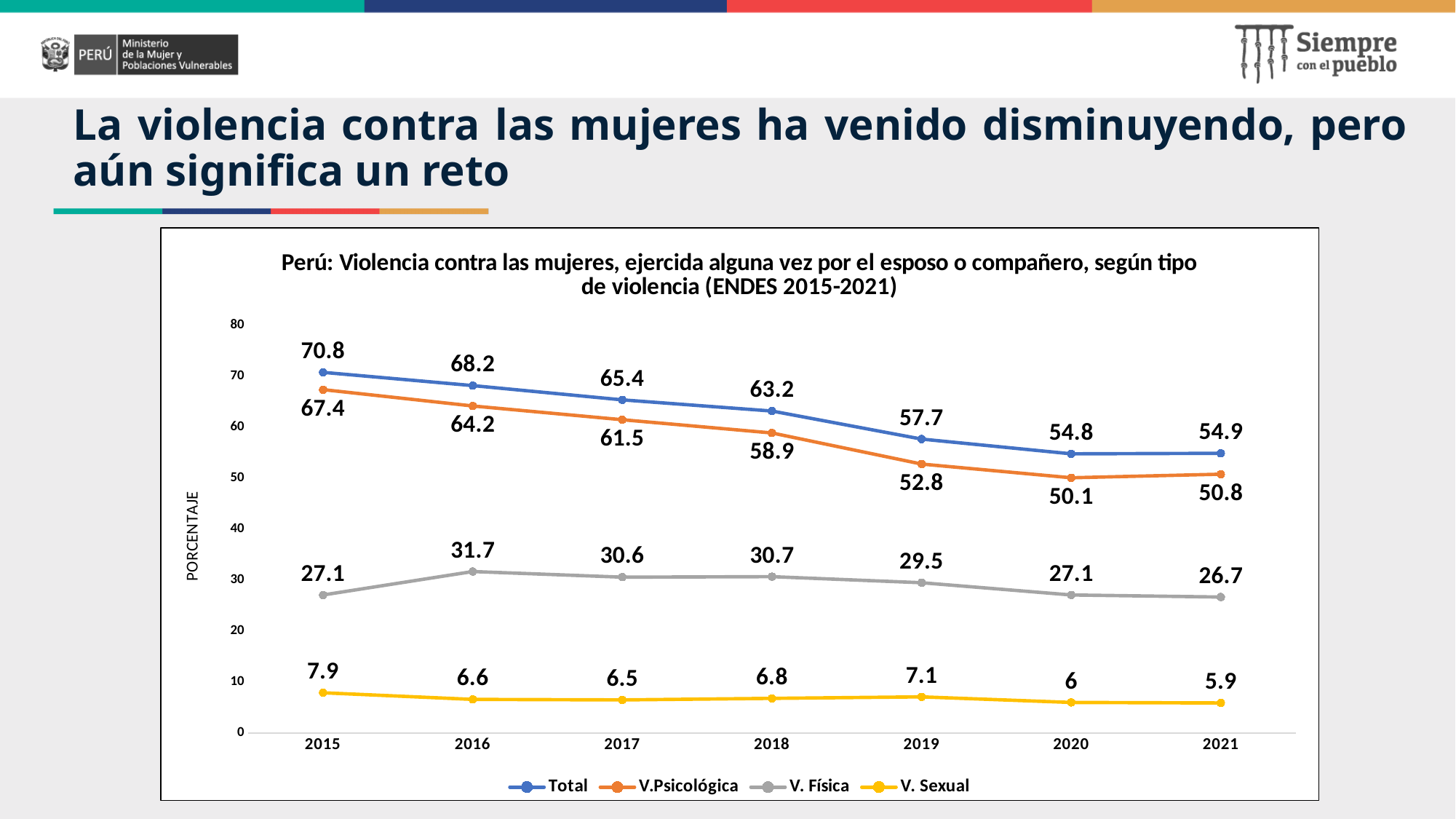
What is the difference between the Total value in 2015 and in 2021? 15.9 In which year is the V. Sexual series lowest? 2021 How many years are shown on the x axis? 7 What kind of chart is shown on the slide? Line chart How many series does the legend list? 4 Does the V.Psicológica series generally rise or fall from 2015 to 2021? Fall What is the value of V.Psicológica in 2019? 52.8 What is the value of the Total series in 2015? 70.8 Which is larger, V. Física in 2018 or V. Física in 2020? V. Física in 2018 What is the value of V. Sexual in 2021? 5.9 In which year is the Total series highest? 2015 What is the value of V. Física in 2016? 31.7